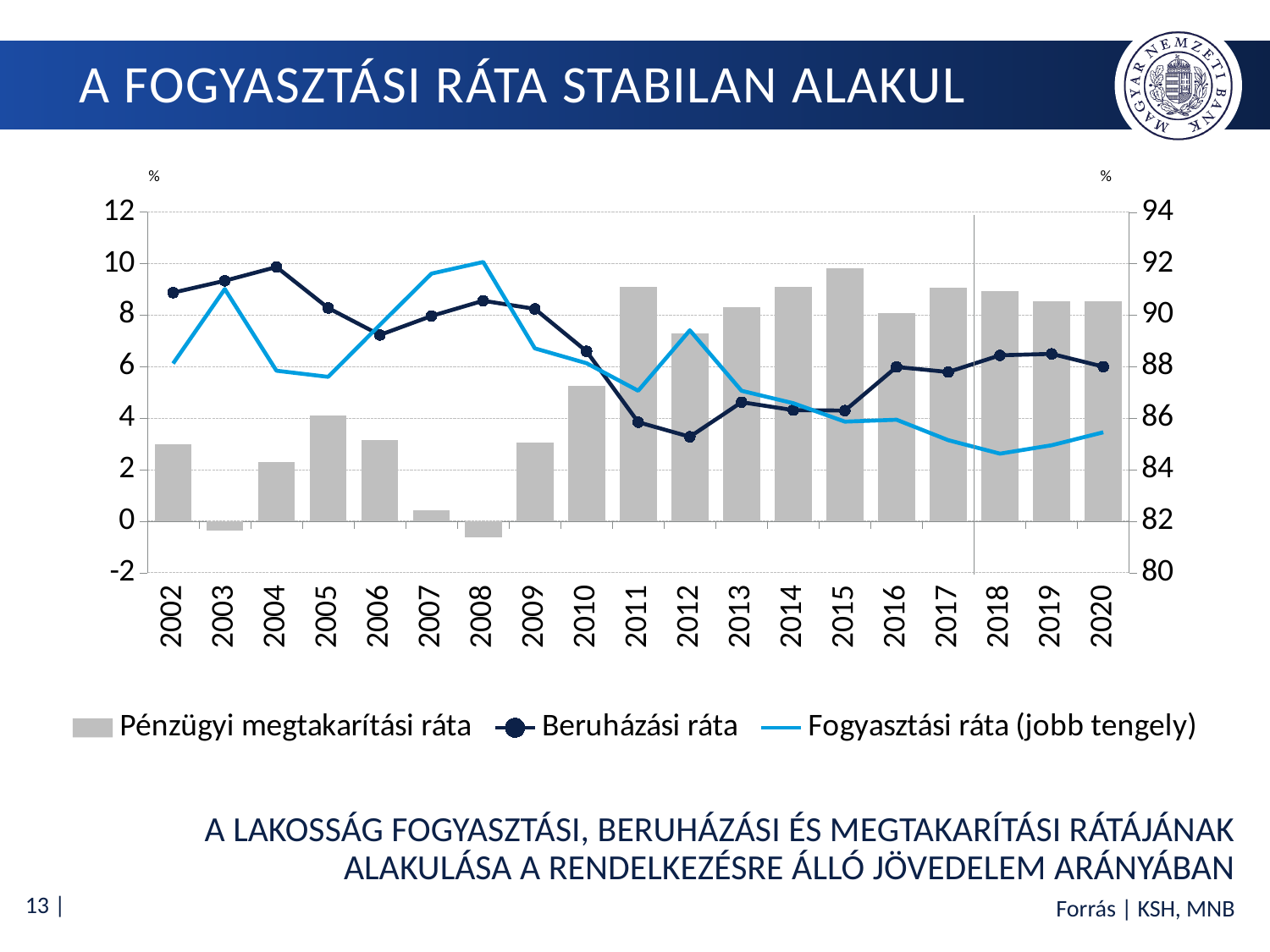
Is the Fogyasztási ráta (jobb tengely) value for 2018 greater or less than 86? less What kind of chart is shown on the slide? A combined bar and line chart In which year does the Beruházási ráta line reach its highest value? 2004 In which year does the Fogyasztási ráta (jobb tengely) line reach its highest value? 2008 Is the Pénzügyi megtakarítási ráta value for 2011 greater or less than 8? greater In which year does the Beruházási ráta line reach its lowest value? 2012 In which year is the Pénzügyi megtakarítási ráta bar the lowest? 2008 Is the Beruházási ráta value for 2012 greater or less than 4? less In which year is the Pénzügyi megtakarítási ráta bar the highest? 2015 How many series does the legend list? 3 How many years are shown on the x axis of the chart? 19 Which year has the larger Pénzügyi megtakarítási ráta bar, 2004 or 2005? 2005